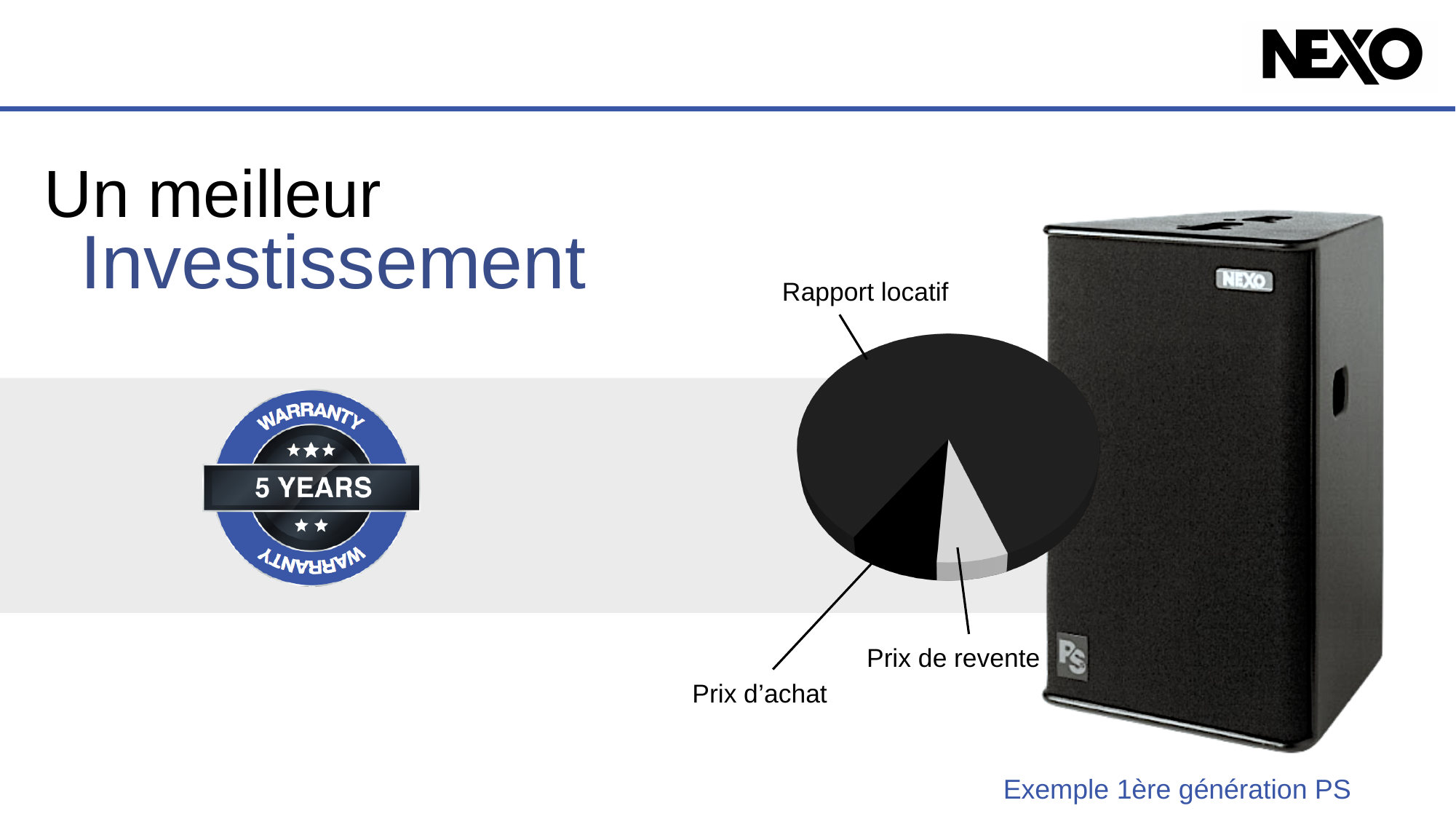
Which slice of the pie chart is the largest? Rapport locatif What kind of chart is shown on the slide? Pie chart Does the Rapport locatif slice take up more or less than half of the pie? More Which slice of the pie chart is shown in light grey? Prix de revente Which is larger in the pie chart, Rapport locatif or Prix d'achat? Rapport locatif Which is larger in the pie chart, Rapport locatif or Prix de revente? Rapport locatif How many slices does the pie chart have? 3 What are the three categories labelled on the pie chart? Rapport locatif, Prix d'achat, Prix de revente